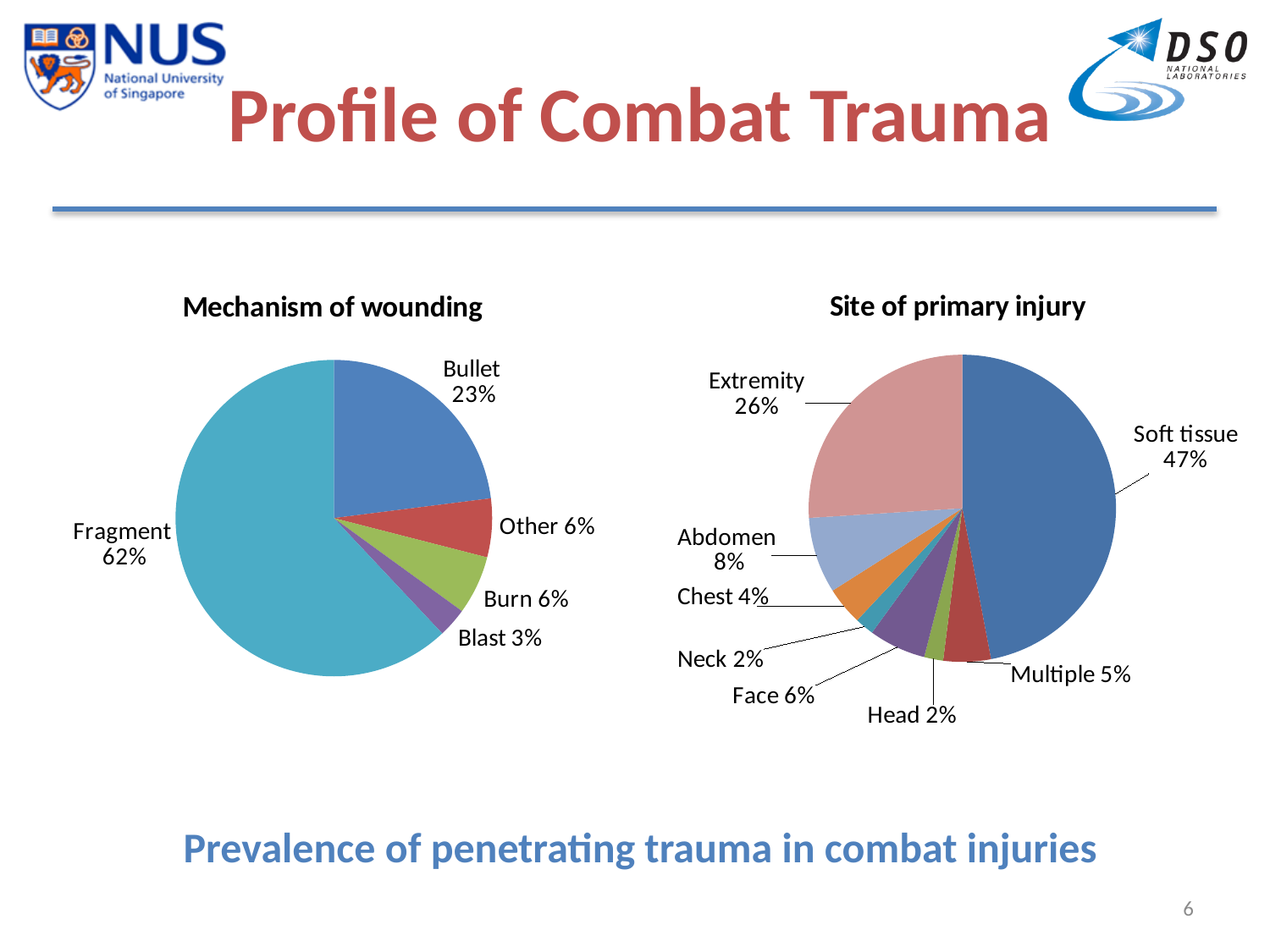
In the 'Mechanism of wounding' chart, what percentage is Fragment? 62% In the 'Mechanism of wounding' chart, what percentage is Bullet? 23% In the 'Site of primary injury' chart, which category has the largest share? Soft tissue What kind of chart is 'Site of primary injury'? Pie chart In the 'Site of primary injury' chart, what percentage is Abdomen? 8% In the 'Mechanism of wounding' chart, what is the difference between Fragment and Bullet? 39% In the 'Mechanism of wounding' chart, how many slices does the pie have? 5 In the 'Site of primary injury' chart, how many categories are shown? 8 In the 'Mechanism of wounding' chart, which category has the smallest share? Blast In the 'Site of primary injury' chart, what percentage is Soft tissue? 47% In the 'Site of primary injury' chart, what is the difference between Soft tissue and Extremity? 21% In the 'Site of primary injury' chart, which is larger, Extremity or Abdomen? Extremity